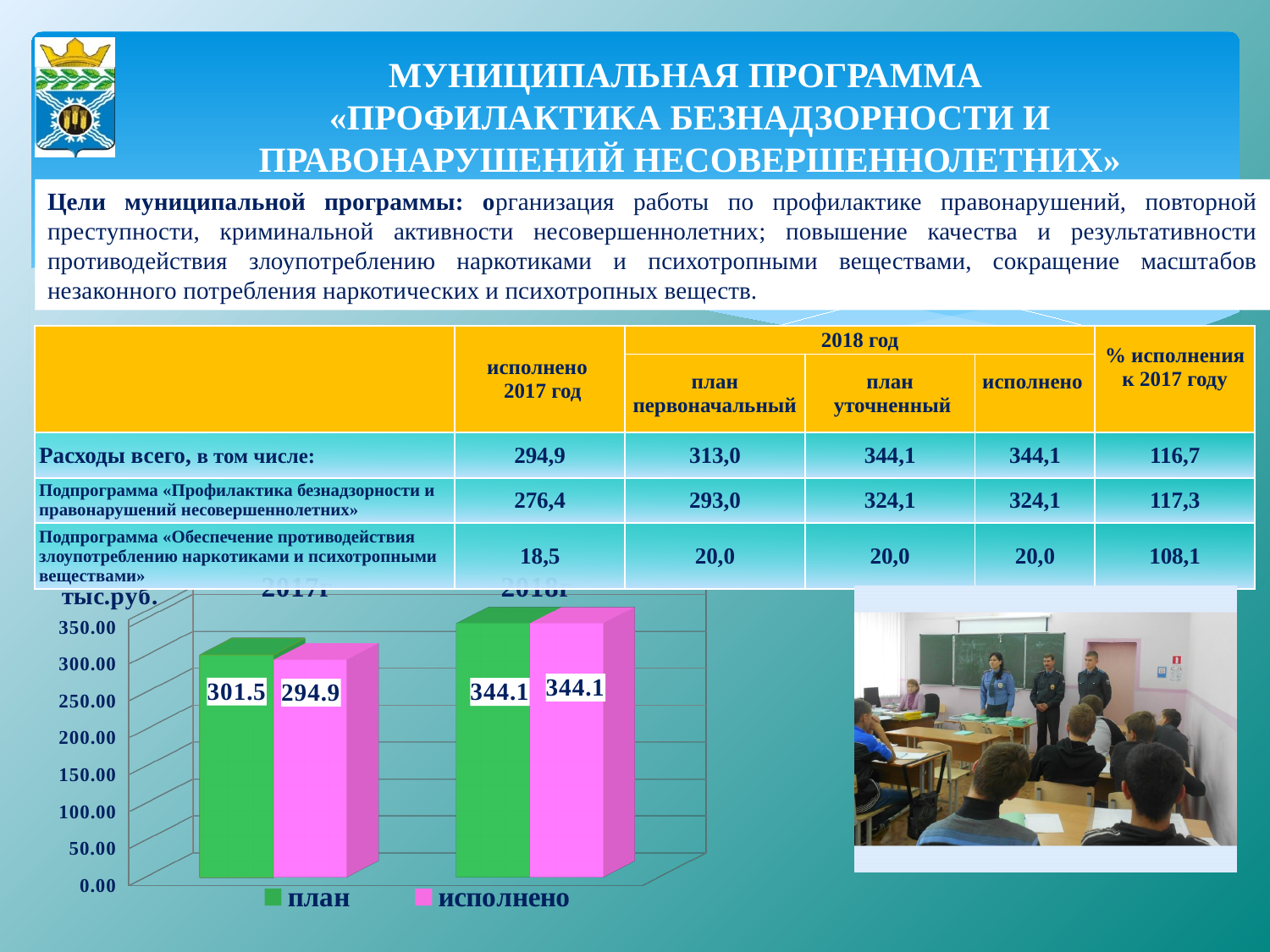
What is the value of the план bar for the right group (2018) in the chart? 344.1 What colour are the план bars in the chart? green What is the value of the исполнено bar for the left group (2017) in the chart? 294.9 What kind of chart is shown on the slide? bar chart How many series does the chart legend list? 2 How many groups of bars (categories) are shown in the chart? 2 Is the исполнено value for the right group (2018) greater or less than 300.00? greater What is the difference between the план and исполнено values for the left group (2017)? 6.6 What is the value of the план bar for the left group (2017) in the chart? 301.5 For the left group (2017), which is larger: план or исполнено? план Does the исполнено value rise or fall from the left group (2017) to the right group (2018)? rise Which bar in the chart has the lowest value? исполнено for 2017 (294.9)